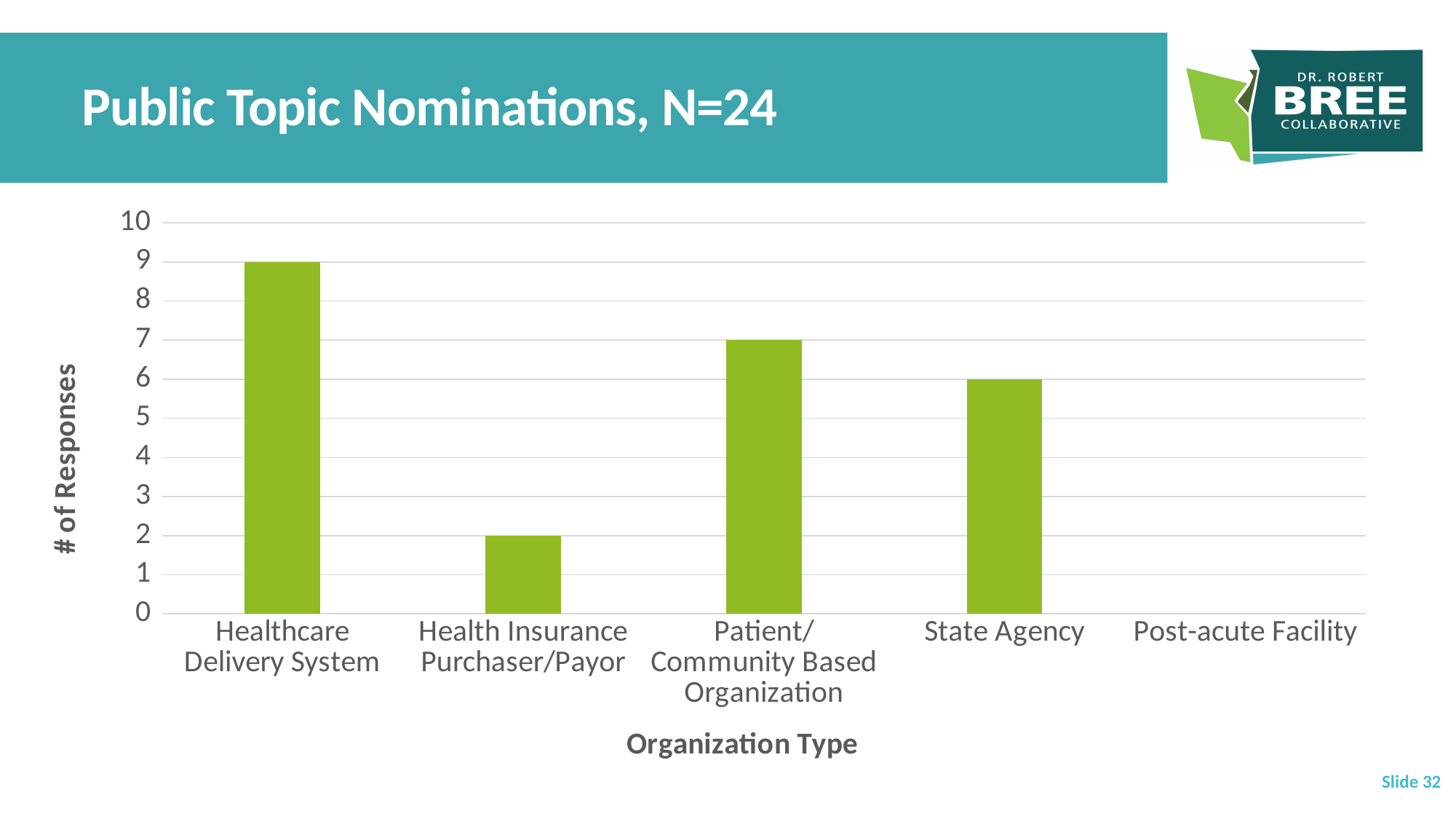
Is the value for Health Insurance Purchaser/Payor greater or less than 5? less How many organization types are shown on the x axis of the chart? 5 What kind of chart is shown on the slide? Bar chart Which has more responses, Patient/Community Based Organization or State Agency? Patient/Community Based Organization Which organization type has the lowest number of responses? Post-acute Facility What is the difference in responses between Healthcare Delivery System and State Agency? 3 Which organization type has the highest number of responses? Healthcare Delivery System What is the number of responses for Healthcare Delivery System? 9 What is the number of responses for State Agency? 6 What is the number of responses for Patient/Community Based Organization? 7 What is the number of responses for Health Insurance Purchaser/Payor? 2 What is the title of the chart's y axis? # of Responses